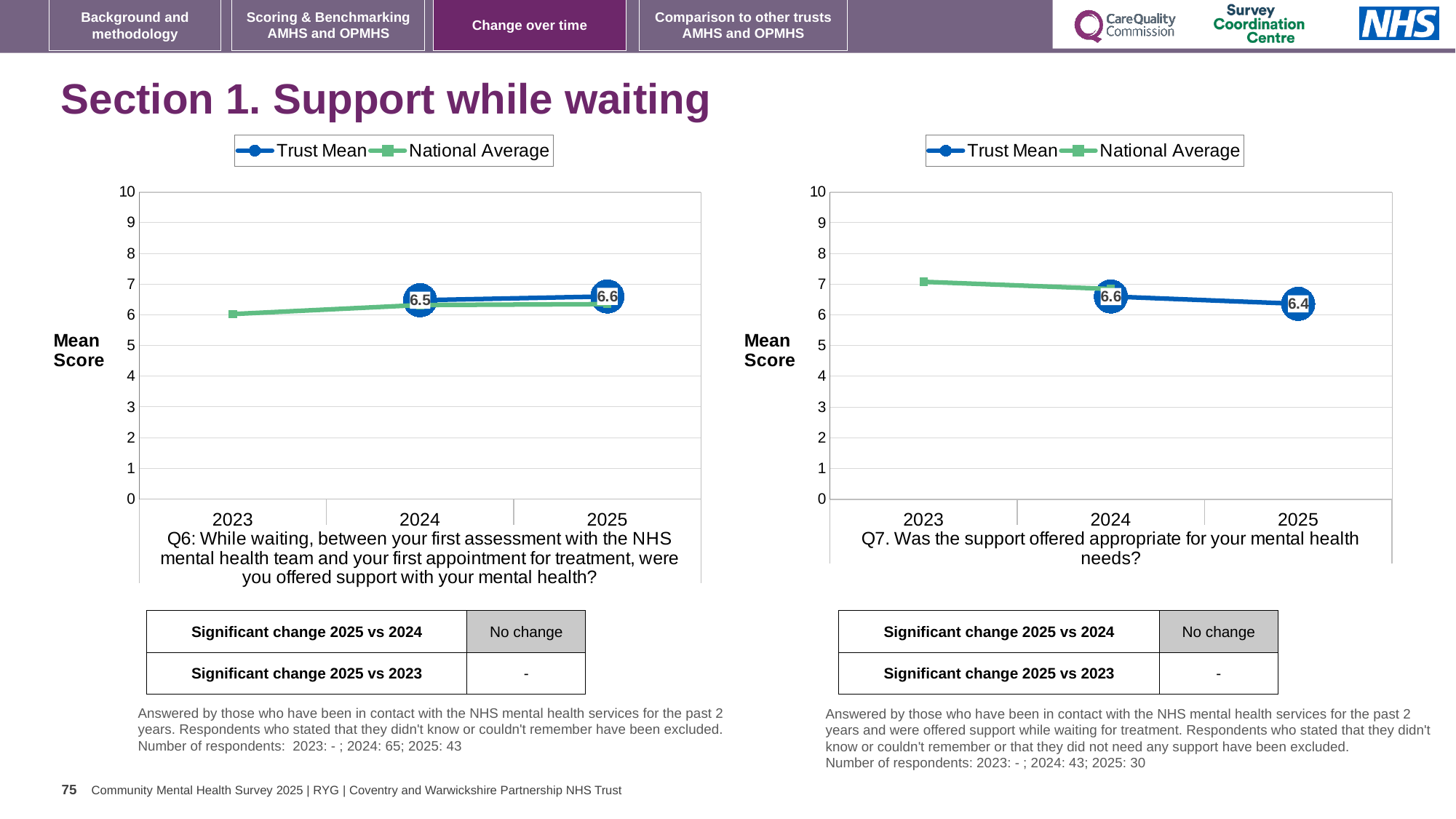
In the Q7 chart on the right, what is the Trust Mean score for 2025? 6.4 How many series does the legend of the Q6 chart on the left list? 2 In the Q7 chart on the right, which year has the higher Trust Mean, 2024 or 2025? 2024 In the Q6 chart on the left, what is the Trust Mean score for 2025? 6.6 In the Q7 chart on the right, does the Trust Mean rise or fall from 2024 to 2025? fall What type of chart is the Q7 chart on the right? line chart In the Q7 chart on the right, is the National Average for 2023 greater or less than 8? less In the Q7 chart on the right, by how much did the Trust Mean change from 2024 to 2025? 0.2 In the Q6 chart on the left, what is the Trust Mean score for 2024? 6.5 In the Q6 chart on the left, is the National Average for 2023 greater or less than 7? less In the Q6 chart on the left, does the Trust Mean rise or fall from 2024 to 2025? rise In the Q7 chart on the right, what is the Trust Mean score for 2024? 6.6